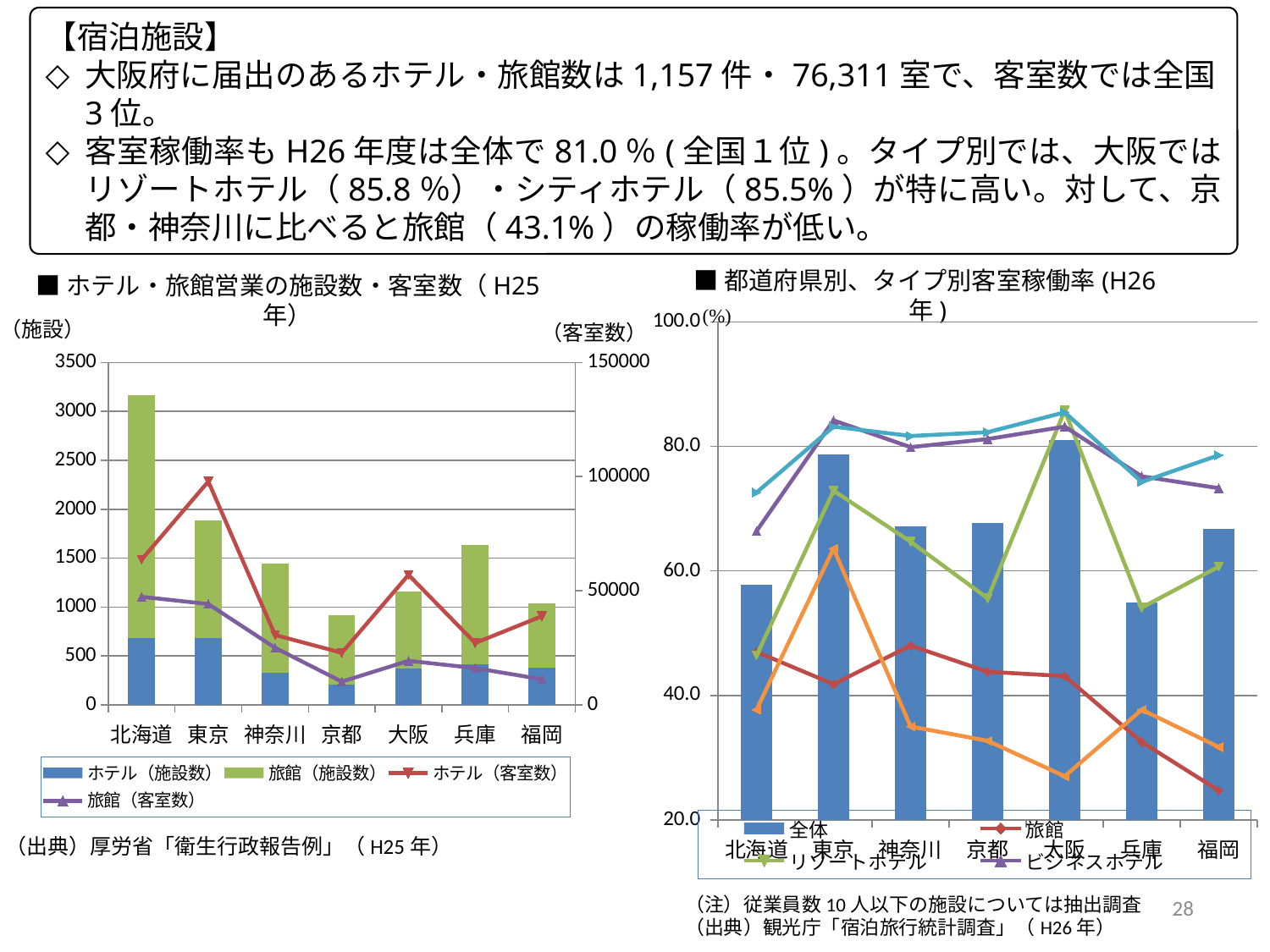
In the right chart (都道府県別、タイプ別客室稼働率), which prefecture has the lowest 旅館 value? 福岡 In the left chart (ホテル・旅館営業の施設数・客室数), is the total stacked bar for 京都 greater or less than 1000? less In the left chart (ホテル・旅館営業の施設数・客室数), is the total stacked bar for 北海道 greater or less than 3000? greater In the right chart (都道府県別、タイプ別客室稼働率), is the 全体 value for 兵庫 greater or less than 60.0? less In the right chart (都道府県別、タイプ別客室稼働率), which prefecture has the highest 全体 bar? 大阪 In the left chart (ホテル・旅館営業の施設数・客室数), which prefecture has the highest 旅館（施設数）? 北海道 In the left chart (ホテル・旅館営業の施設数・客室数), which prefecture has the highest ホテル（客室数）? 東京 In the right chart (都道府県別、タイプ別客室稼働率), which has the larger 全体 value, 東京 or 神奈川? 東京 What kind of chart is the left chart, ホテル・旅館営業の施設数・客室数（H25年）? bar chart with line series In the left chart (ホテル・旅館営業の施設数・客室数), how many series does the legend list? 4 In the right chart (都道府県別、タイプ別客室稼働率), how many prefectures are shown on the x axis? 7 In the left chart (ホテル・旅館営業の施設数・客室数), how many prefectures are shown on the x axis? 7